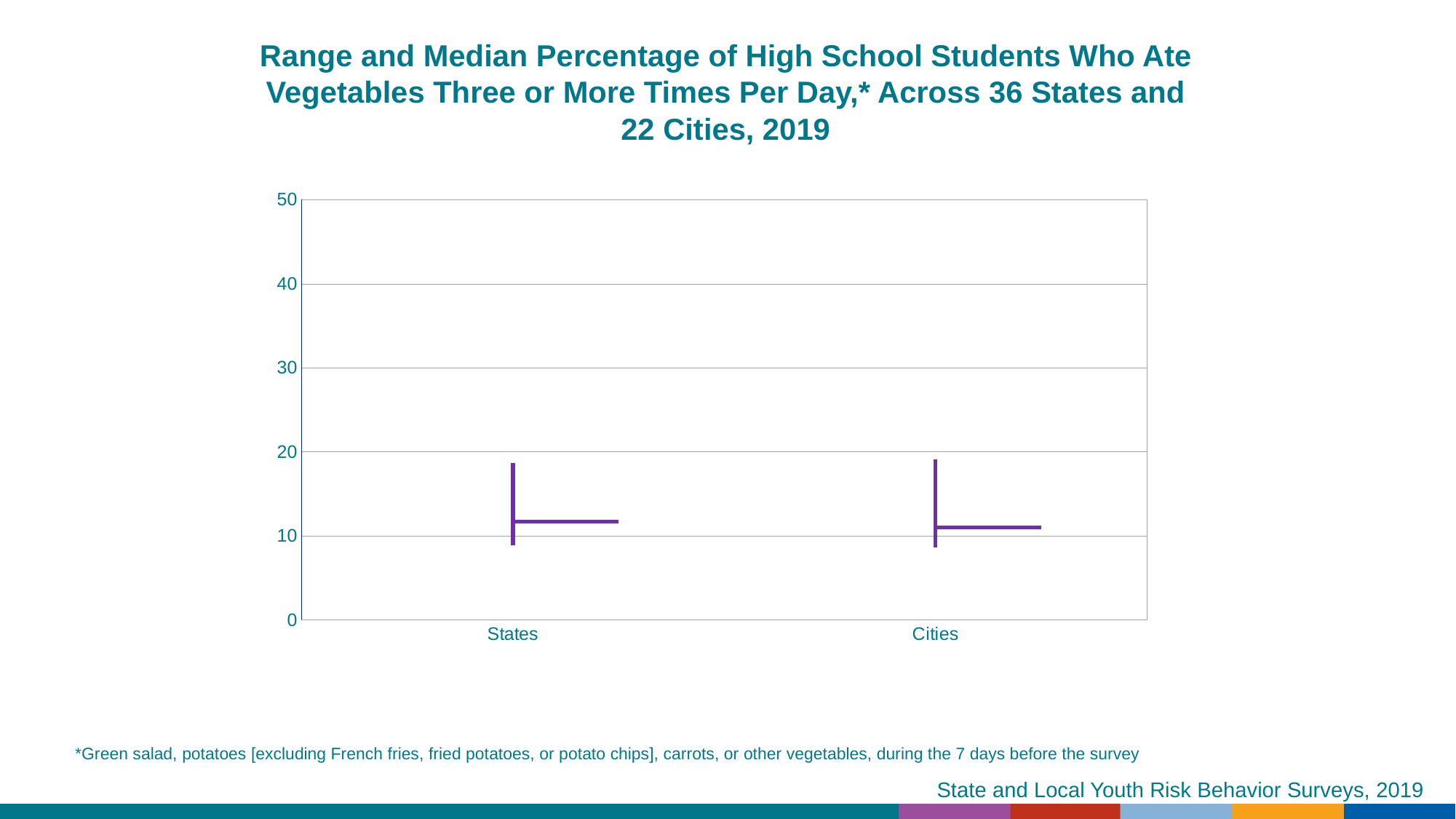
Is the top of the range for States greater or less than 20? less Is the median value for States greater or less than 10? greater According to the chart title, how many states are included in the data? 36 How many categories are shown on the x axis of the chart? 2 According to the chart title, how many cities are included in the data? 22 What is the highest value shown on the y axis of the chart? 50 What are the two categories labelled on the x axis? States and Cities Is the top of the range for Cities greater or less than 20? less